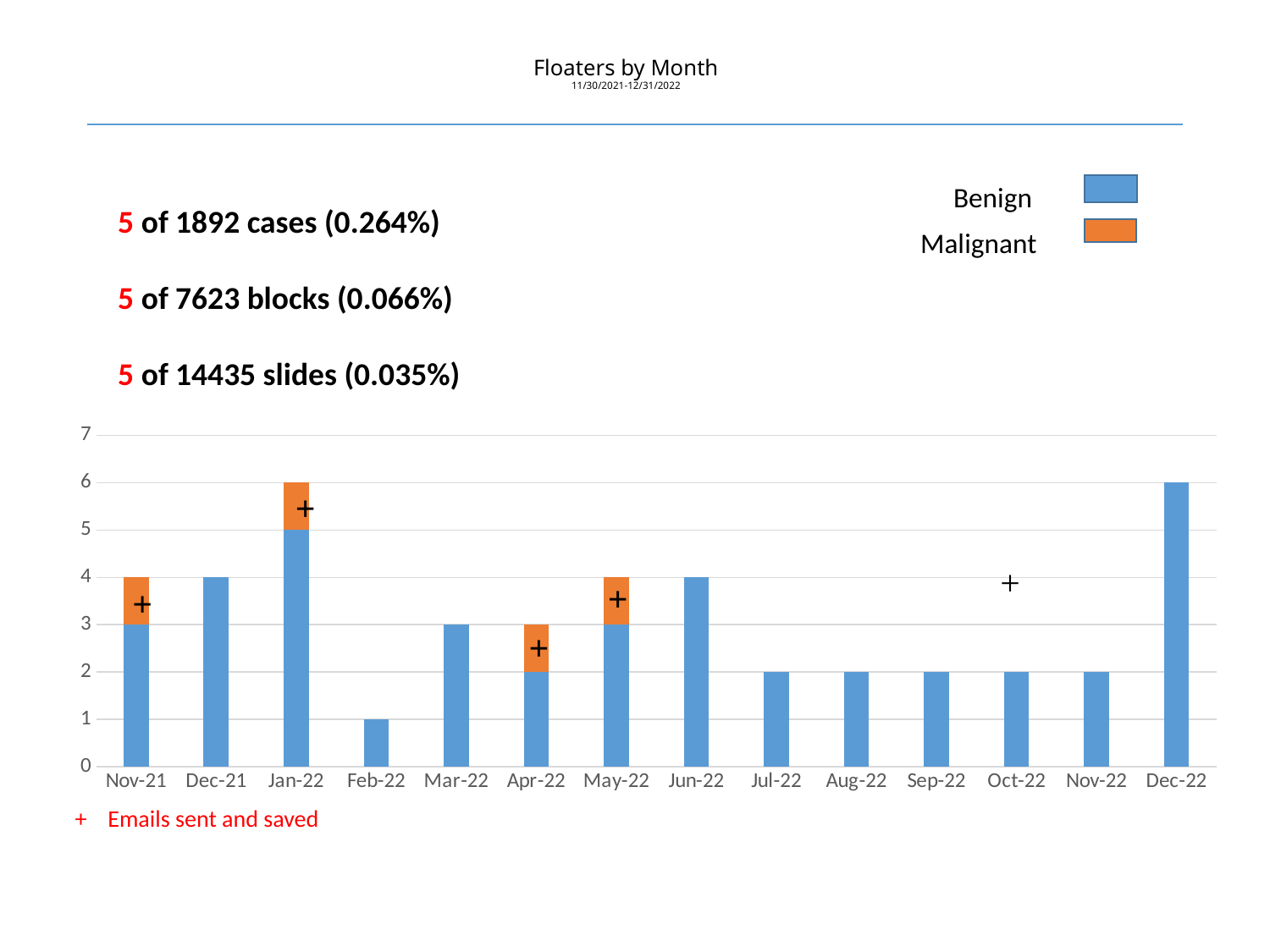
What is the value for Dec-22? 6 What is the Malignant value for Apr-22? 1 Is the value for Dec-22 greater or less than 5? greater What is the title of the chart? Floaters by Month What is the difference between the total for Jan-22 and the total for Feb-22? 5 What is the Benign value for Nov-21? 3 Which month has the lowest total bar? Feb-22 What is the total height of the stacked bar for Jan-22? 6 How many months are shown on the x axis of the chart? 14 Which is larger, the total bar for Jun-22 or the total bar for Jul-22? Jun-22 How many series does the legend list? 2 What kind of chart is shown on the slide? bar chart